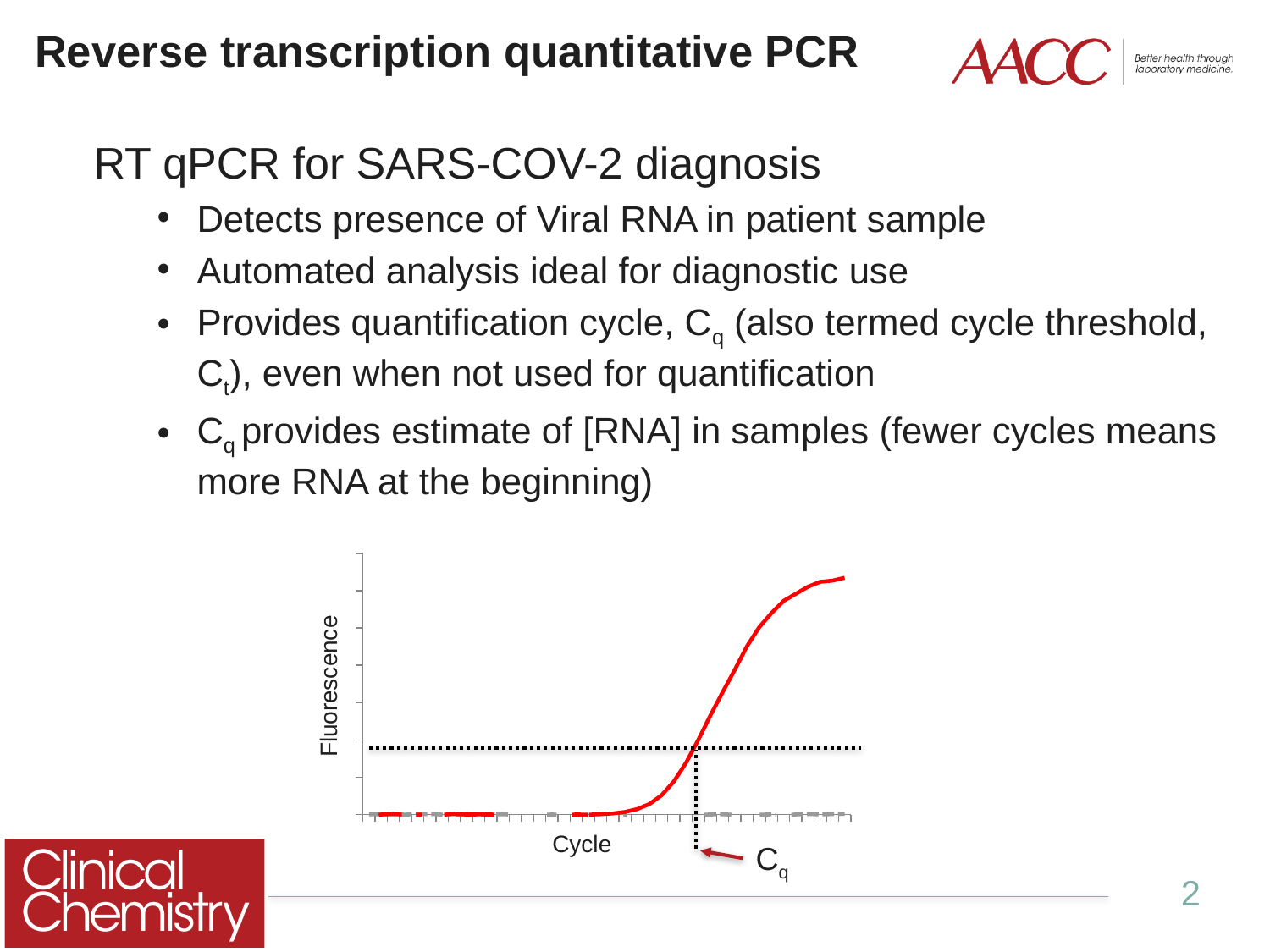
What kind of chart is shown at the bottom of the slide? line chart What is the label of the y axis of the chart? Fluorescence Does the red fluorescence curve rise or fall as the cycle number increases along the x axis? rise How many plotted curves (series) are shown in the chart? 2 What is the label of the x axis of the chart? Cycle